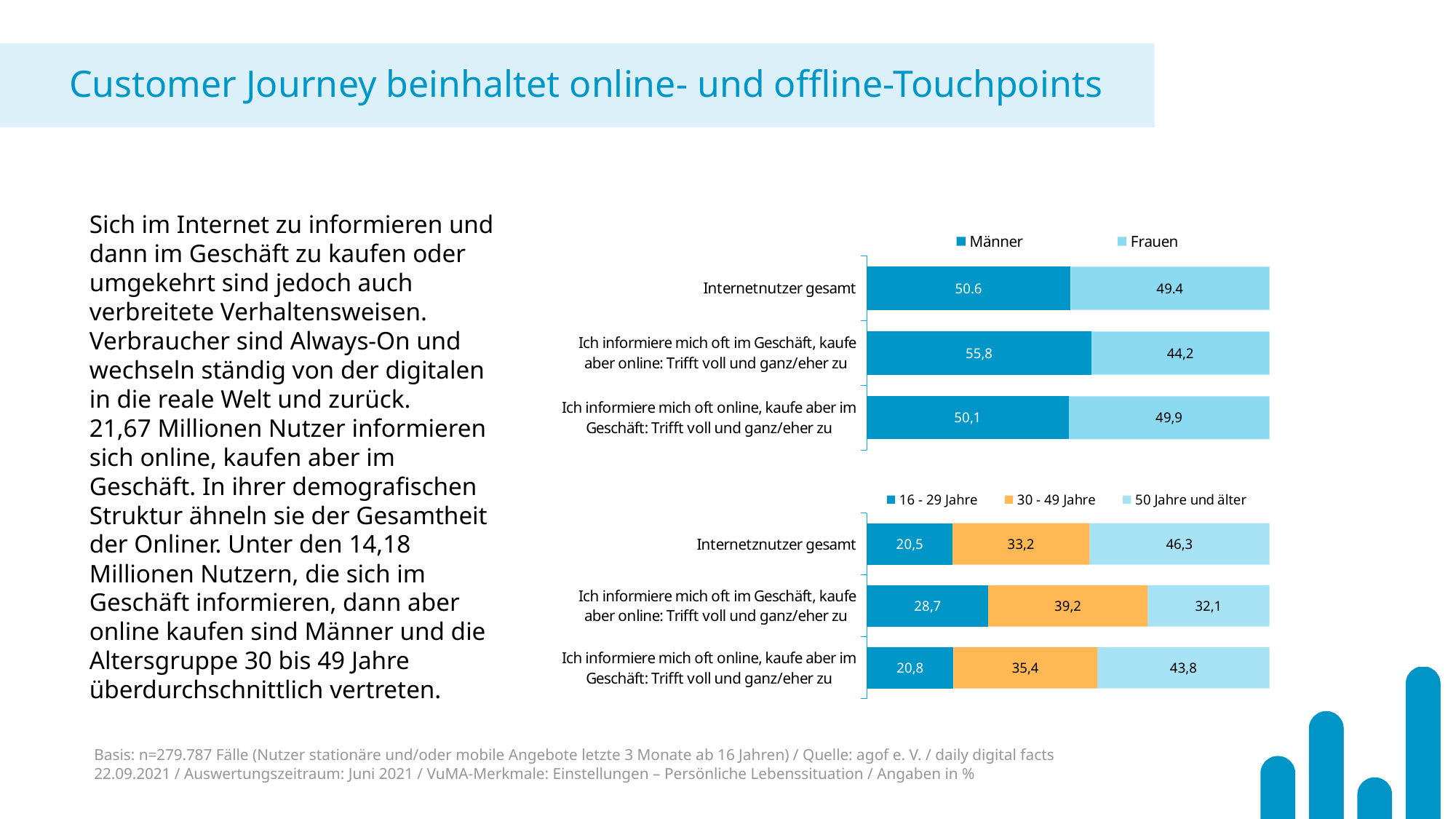
In the bottom chart (age groups), what is the value for '50 Jahre und älter' for 'Internetznutzer gesamt'? 46,3 In the bottom chart (age groups), which category has the highest value for '16 - 29 Jahre'? Ich informiere mich oft im Geschäft, kaufe aber online: Trifft voll und ganz/eher zu In the bottom chart (age groups), is the '30 - 49 Jahre' value larger for 'Internetznutzer gesamt' or for 'Ich informiere mich oft online, kaufe aber im Geschäft'? Ich informiere mich oft online, kaufe aber im Geschäft In the top chart (Männer/Frauen), how many series does the legend list? 2 In the top chart (Männer/Frauen), what is the value for Frauen for 'Ich informiere mich oft im Geschäft, kaufe aber online: Trifft voll und ganz/eher zu'? 44,2 In the top chart (Männer/Frauen), what is the difference between the Männer and Frauen values for 'Ich informiere mich oft im Geschäft, kaufe aber online'? 11,6 In the bottom chart (age groups), how many series does the legend list? 3 In the bottom chart (age groups), which category has the lowest value for '50 Jahre und älter'? Ich informiere mich oft im Geschäft, kaufe aber online: Trifft voll und ganz/eher zu In the top chart (Männer/Frauen), what is the value for Männer for 'Internetnutzer gesamt'? 50.6 What type of chart is the bottom chart (age groups)? Stacked bar chart In the bottom chart (age groups), what is the value for '30 - 49 Jahre' for 'Ich informiere mich oft im Geschäft, kaufe aber online'? 39,2 In the bottom chart (age groups), how many categories are shown? 3